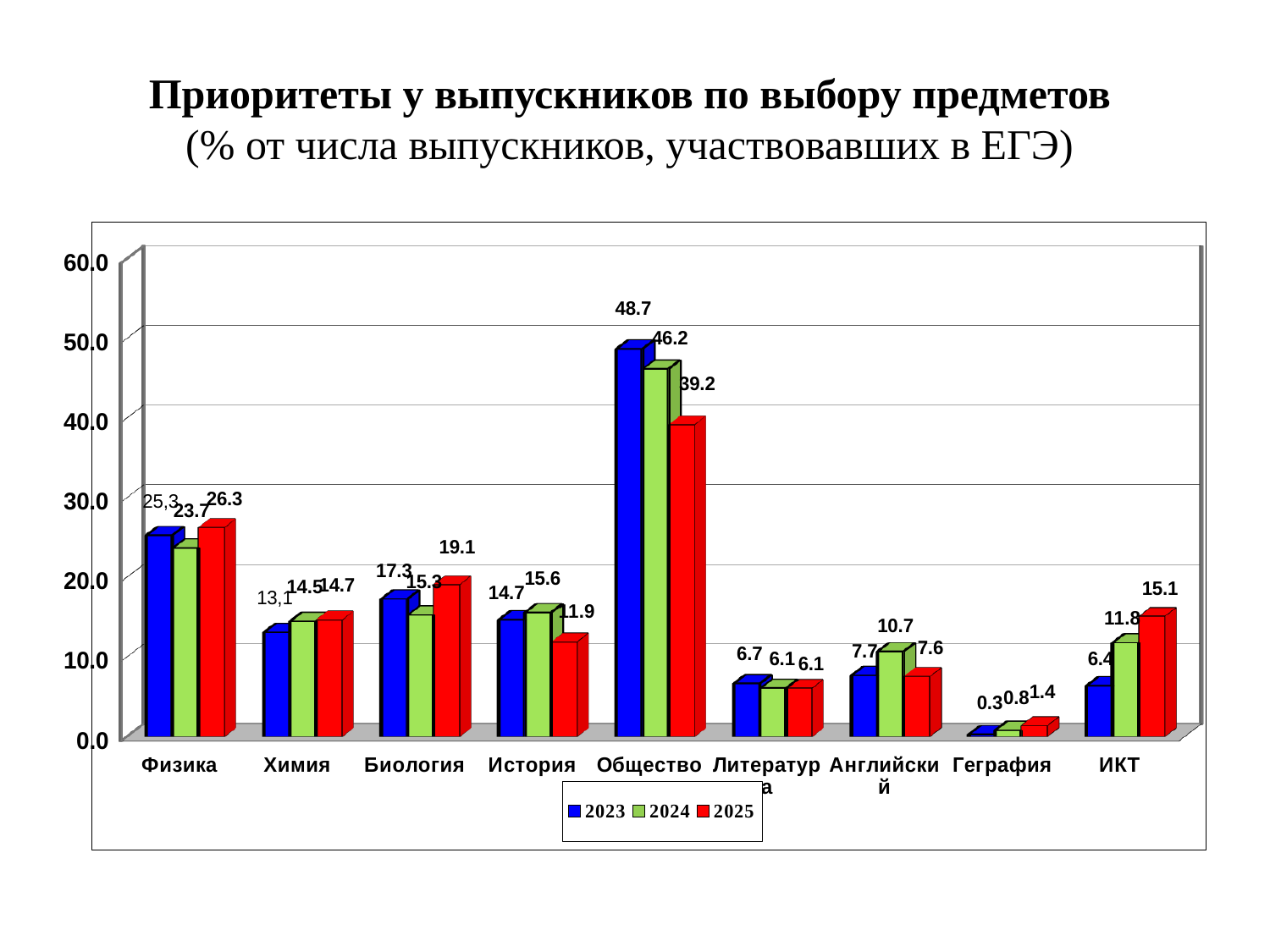
Do the values for ИКТ rise or fall from 2023 to 2025? rise Which subject has the highest value in 2025? Общество What is the value for ИКТ in 2025? 15.1 What is the value for Английский in 2024? 10.7 How many series does the legend list? 3 What is the value for Общество in 2023? 48.7 What type of chart is shown on the slide? bar chart Which colour represents the 2024 series in the legend? green How many subject categories are shown on the x axis? 9 Which is larger for Биология: the 2024 value or the 2025 value? 2025 Which subject has the lowest value in 2023? Геграфия What is the difference between the 2023 and 2025 values for Общество? 9.5